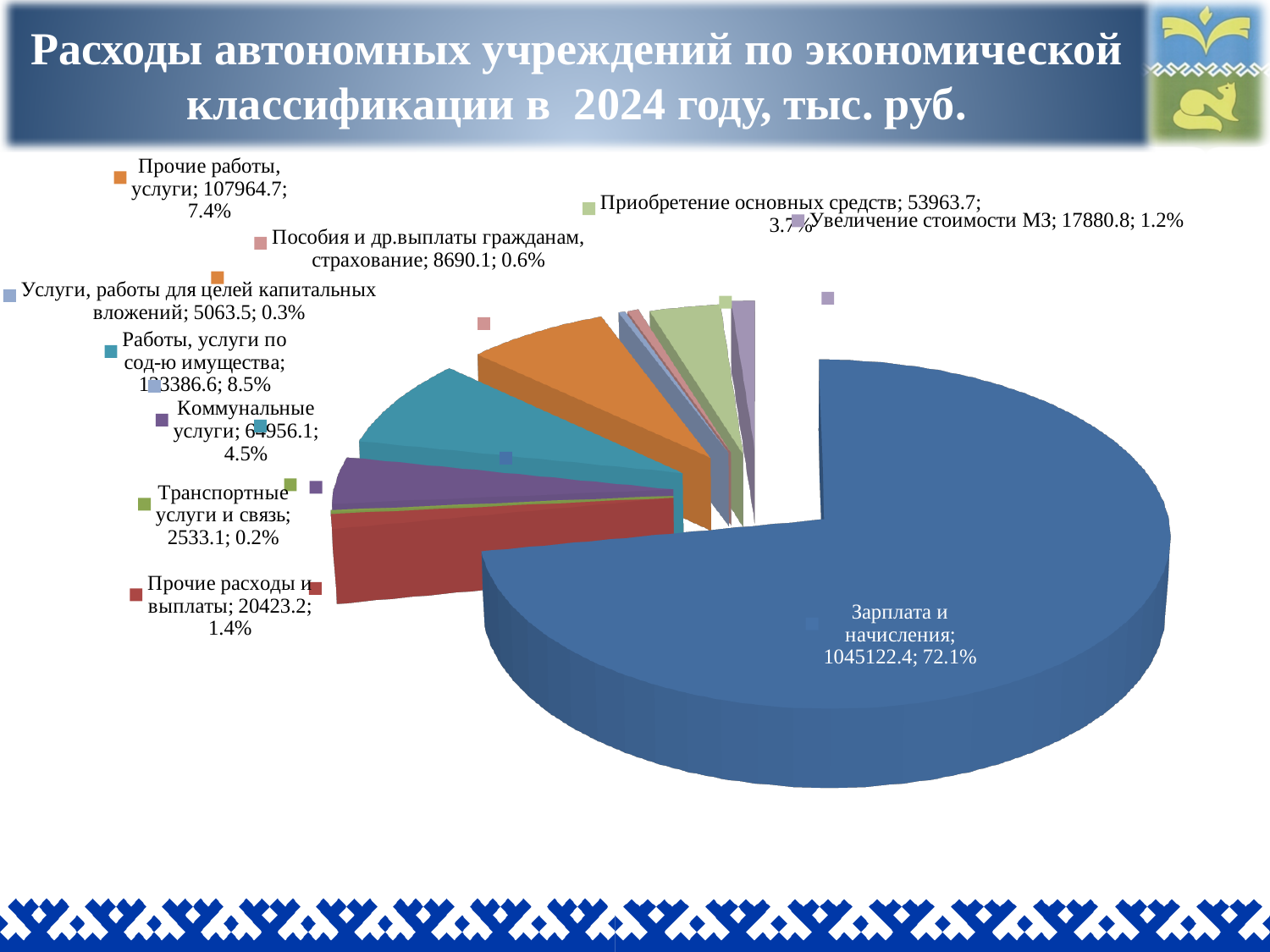
What is the value for Прочие работы, услуги? 107964.7 How many categories are shown in the pie chart? 10 Which category has the smallest share of expenses in the pie chart? Транспортные услуги и связь Which category has the largest share of expenses in the pie chart? Зарплата и начисления What share of the pie does Работы, услуги по сод-ю имущества take? 8.5% What is the value for Приобретение основных средств? 53963.7 Which is larger: Прочие расходы и выплаты or Увеличение стоимости МЗ? Прочие расходы и выплаты What kind of chart is shown on the slide? pie chart What year does the chart title refer to? 2024 What is the difference between Приобретение основных средств and Увеличение стоимости МЗ? 36082.9 What is the value for Зарплата и начисления? 1045122.4 What share of the pie does Зарплата и начисления take? 72.1%